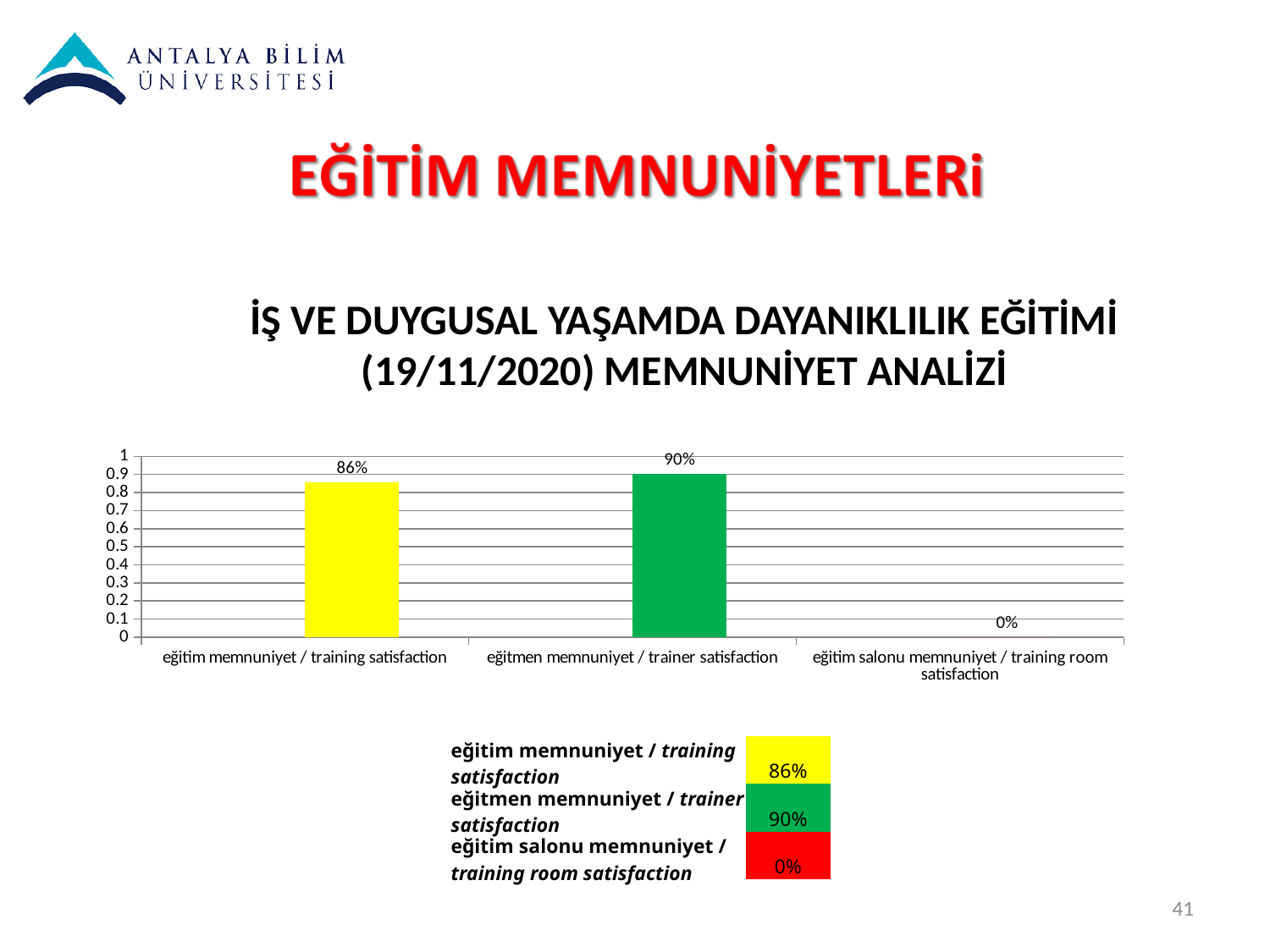
What is the difference between the trainer satisfaction value and the training satisfaction value? 4% Which category has the lowest value? eğitim salonu memnuniyet / training room satisfaction What colour is the bar for eğitmen memnuniyet / trainer satisfaction? green How many categories are shown on the x axis of the chart? 3 Is the value for eğitim memnuniyet / training satisfaction greater or less than 0.5? greater What is the value for eğitmen memnuniyet / trainer satisfaction? 90% What kind of chart is shown on the slide? bar chart What is the maximum value shown on the y axis of the chart? 1 What is the value for eğitim memnuniyet / training satisfaction? 86% Which is larger, the value for training satisfaction or the value for trainer satisfaction? trainer satisfaction Which category has the highest value? eğitmen memnuniyet / trainer satisfaction What is the value for eğitim salonu memnuniyet / training room satisfaction? 0%